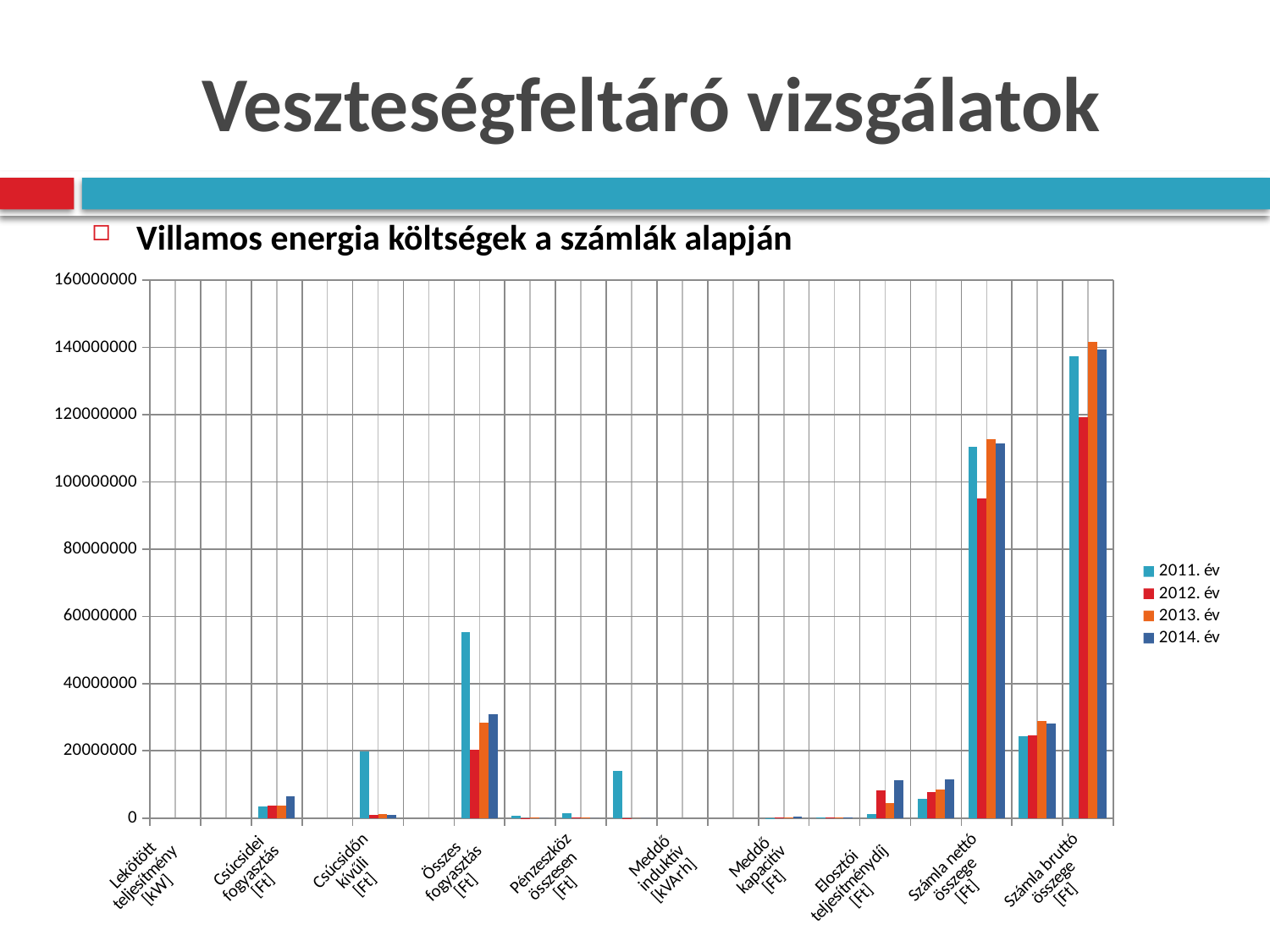
What is the heading shown above the chart? Villamos energia költségek a számlák alapján Is the value for Összes fogyasztás [Ft] in 2011. év greater or less than 40000000? greater How many series does the legend list? 4 Is the value for Számla bruttó összege [Ft] in 2011. év greater or less than 120000000? greater For Számla bruttó összege [Ft], which year has the lowest value? 2012. év Which series is shown in red in the legend? 2012. év For Összes fogyasztás [Ft], which is larger: the 2011. év value or the 2012. év value? 2011. év Is the value for Számla nettó összege [Ft] in 2012. év greater or less than 100000000? less For Számla nettó összege [Ft], which is larger: the 2012. év value or the 2013. év value? 2013. év What kind of chart is shown on the slide? bar chart Which category has the highest bars in the chart? Számla bruttó összege [Ft]